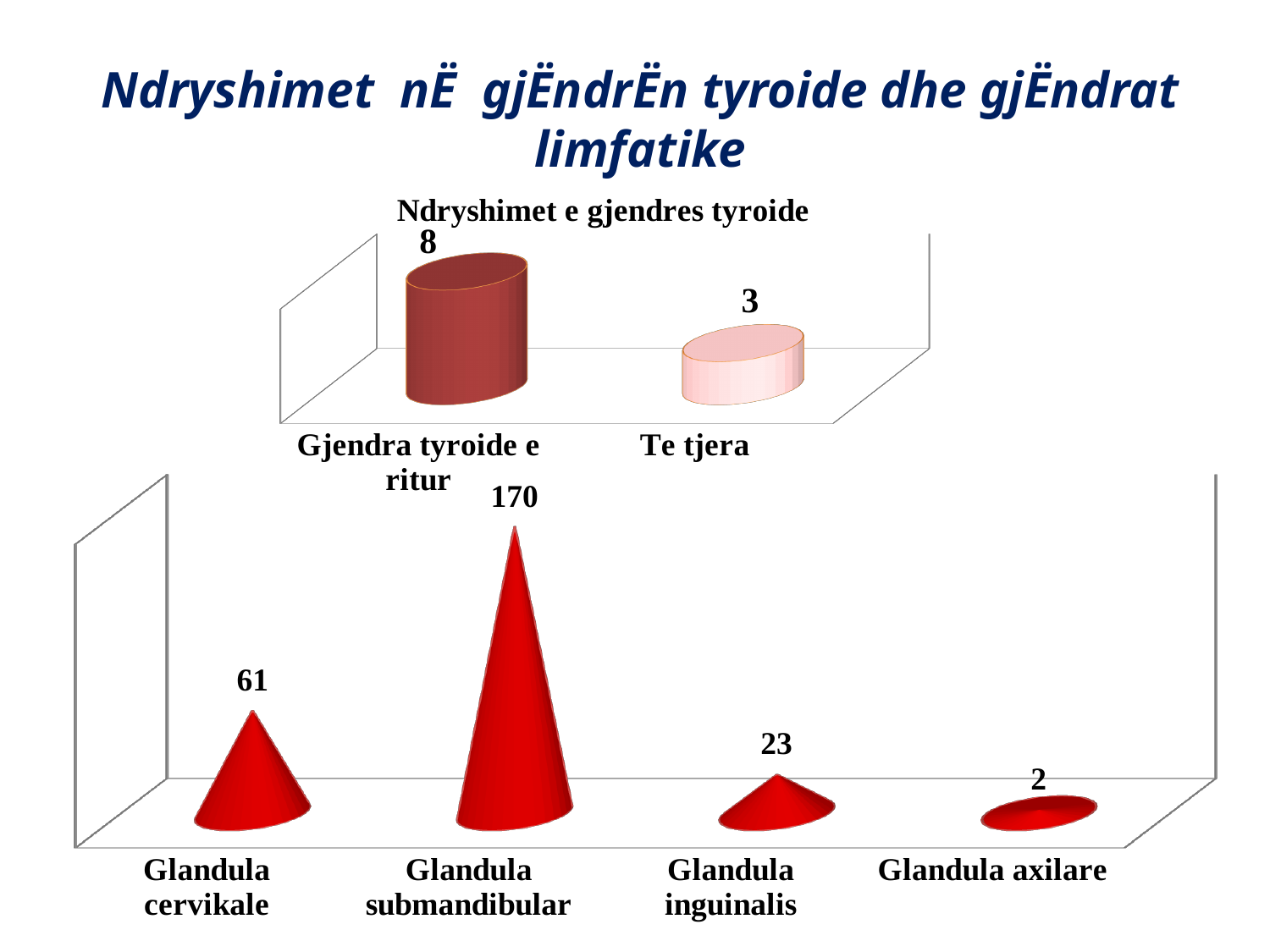
In the bottom chart, which category has the lowest value? Glandula axilare In the chart titled 'Ndryshimet e gjendres tyroide', how many categories are shown? 2 In the chart titled 'Ndryshimet e gjendres tyroide', what is the value for 'Gjendra tyroide e ritur'? 8 In the bottom chart, which is larger: 'Glandula inguinalis' or 'Glandula axilare'? Glandula inguinalis In the bottom chart, what is the difference between 'Glandula submandibular' and 'Glandula cervikale'? 109 In the bottom chart, how many categories are shown? 4 In the bottom chart, what is the value for 'Glandula cervikale'? 61 In the bottom chart, what is the value for 'Glandula inguinalis'? 23 In the bottom chart, what is the value for 'Glandula submandibular'? 170 In the bottom chart, which category has the highest value? Glandula submandibular In the chart titled 'Ndryshimet e gjendres tyroide', what is the difference between 'Gjendra tyroide e ritur' and 'Te tjera'? 5 In the chart titled 'Ndryshimet e gjendres tyroide', what is the value for 'Te tjera'? 3